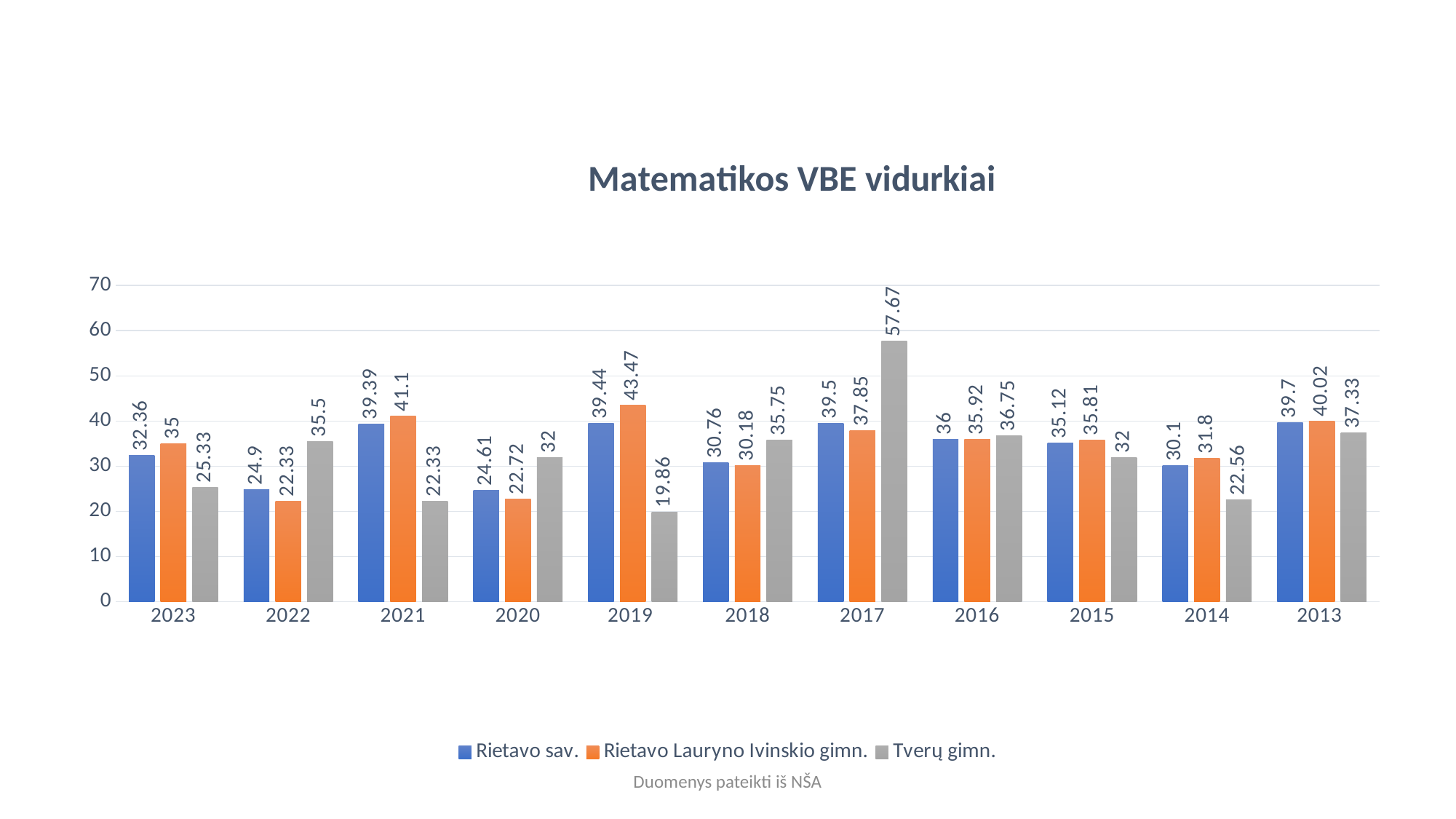
Which is larger in 2022: the Rietavo sav. value or the Tverų gimn. value? Tverų gimn. Which series is shown in grey? Tverų gimn. What is the title of the chart? Matematikos VBE vidurkiai What kind of chart is shown on the slide? Bar chart What is the value for Tverų gimn. in 2017? 57.67 How many years are shown on the x axis? 11 What is the value for Rietavo sav. in 2022? 24.9 How many series does the legend list? 3 In which year is the Tverų gimn. value highest? 2017 What is the difference between the Rietavo Lauryno Ivinskio gimn. value and the Rietavo sav. value in 2019? 4.03 In which year is the Tverų gimn. value lowest? 2019 What is the value for Rietavo Lauryno Ivinskio gimn. in 2021? 41.1